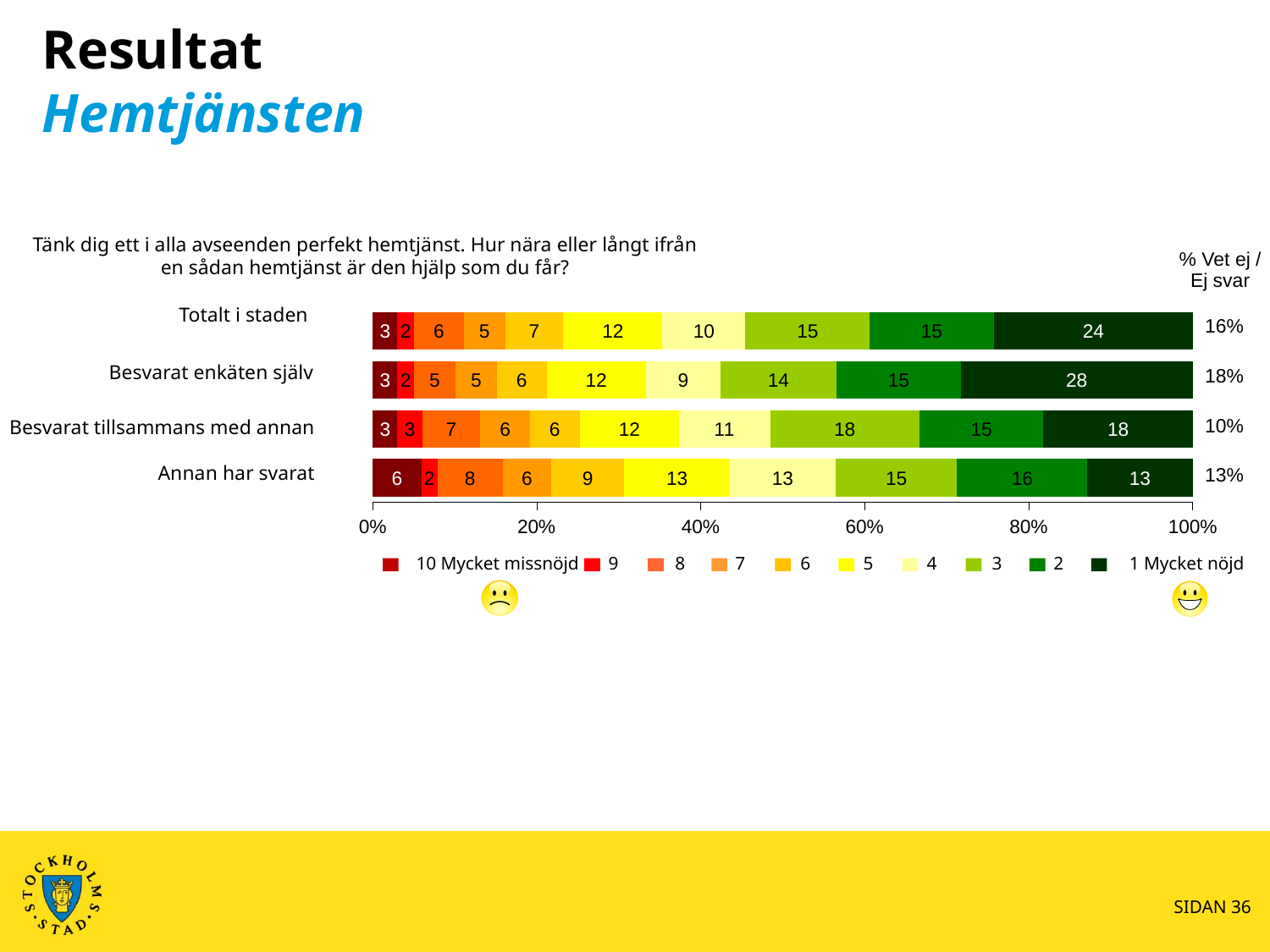
What is the first entry in the chart legend? 10 Mycket missnöjd What kind of chart is shown on the slide? stacked bar chart What is the difference between the '1 Mycket nöjd' values for 'Besvarat enkäten själv' and 'Annan har svarat'? 15 Which is larger: the value of '3' for 'Besvarat tillsammans med annan' or for 'Totalt i staden'? Besvarat tillsammans med annan How many categories (rows) does the chart show? 4 Which category has the highest value for '1 Mycket nöjd'? Besvarat enkäten själv What is the value of '1 Mycket nöjd' for 'Besvarat enkäten själv'? 28 What is the value of '1 Mycket nöjd' for 'Totalt i staden'? 24 How many series does the legend list? 10 What is the '% Vet ej / Ej svar' value for 'Besvarat tillsammans med annan'? 10% What is the value of '10 Mycket missnöjd' for 'Annan har svarat'? 6 Which category has the lowest value for '1 Mycket nöjd'? Annan har svarat